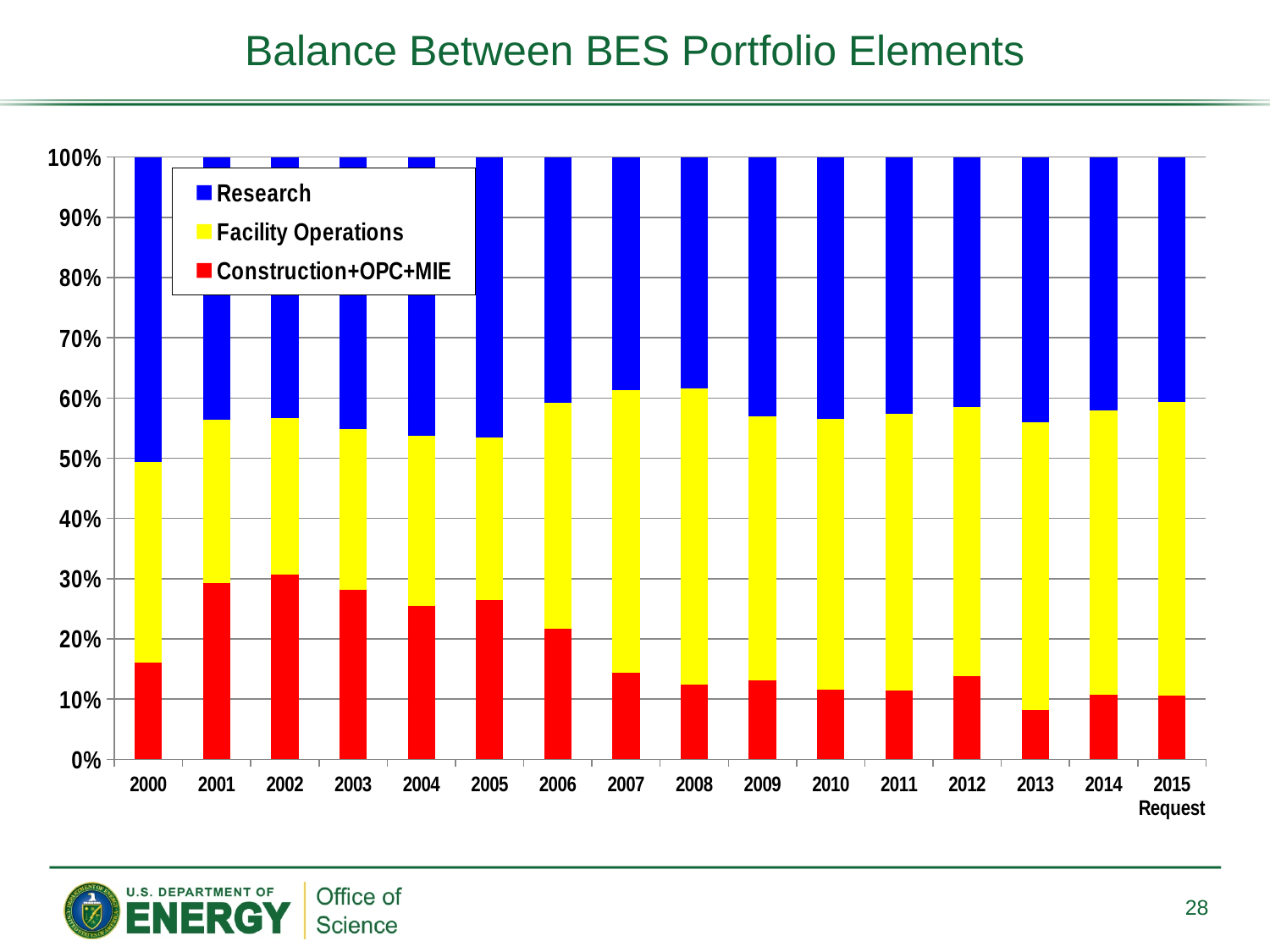
Which year has the smallest Construction+OPC+MIE share? 2013 What kind of chart is shown on the slide? Stacked bar chart Is the Construction+OPC+MIE share for 2001 greater or less than 20%? greater How many years (categories) are shown along the x axis? 16 Is the Construction+OPC+MIE share for 2013 greater or less than 10%? less What is the total of the stacked bar for 2005? 100% Which year has the largest Construction+OPC+MIE share? 2002 Which year has the larger Research share, 2000 or 2007? 2000 Is the Construction+OPC+MIE share for 2000 greater or less than 20%? less Which colour represents Facility Operations in the chart? Yellow How many series does the legend list? 3 Does the Construction+OPC+MIE share generally rise or fall from 2002 to 2013? fall